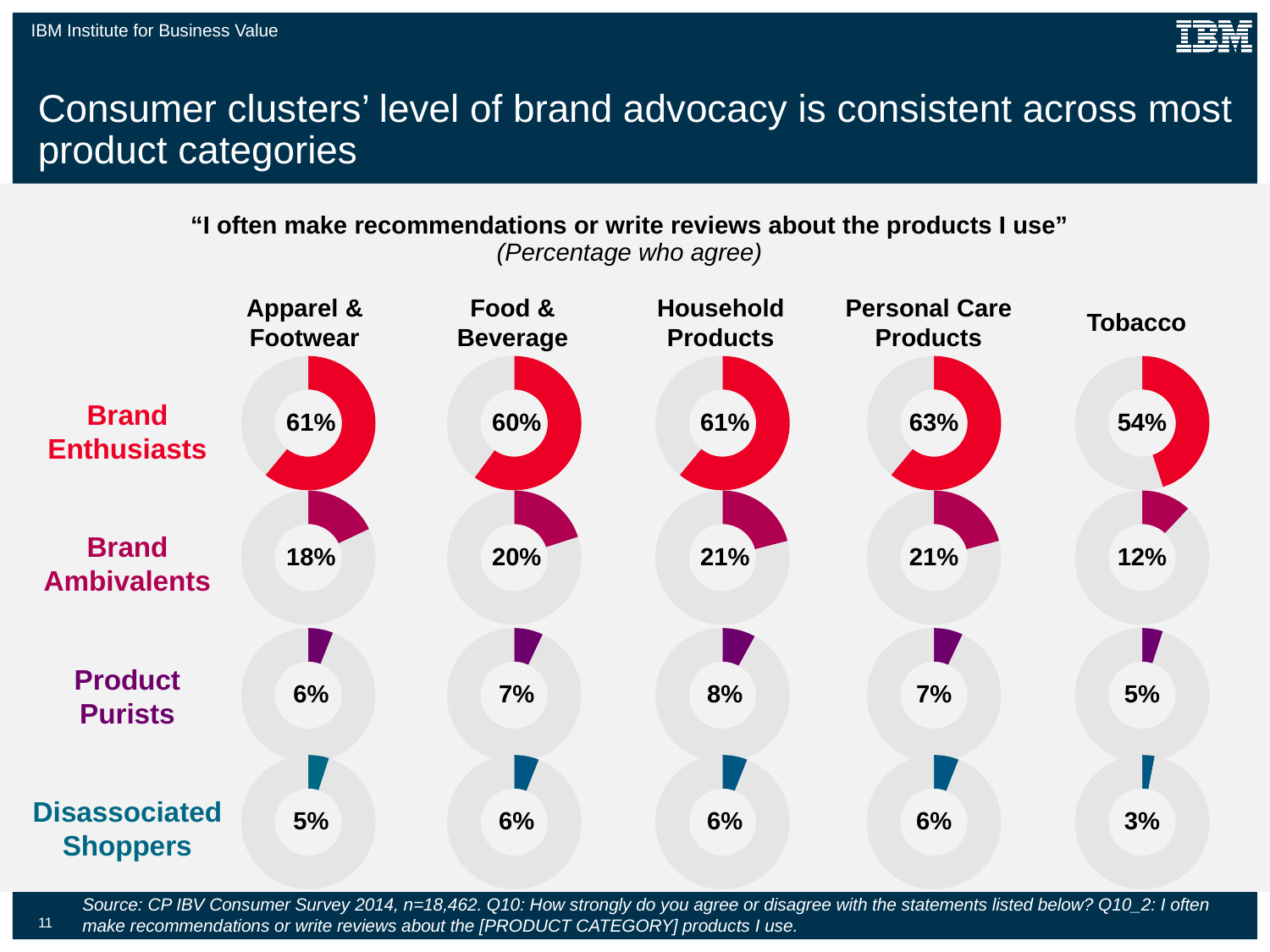
In the Disassociated Shoppers row, what percentage is shown for Apparel & Footwear? 5% In the Brand Ambivalents row, what percentage is shown for Tobacco? 12% In the Brand Ambivalents row, what is the difference between the Household Products value and the Apparel & Footwear value? 3% How many consumer clusters are shown as rows on the slide? 4 In the Brand Enthusiasts row, which product category has the highest percentage? Personal Care Products In the Brand Enthusiasts row, what percentage is shown for Personal Care Products? 63% In the Brand Enthusiasts row, what is the difference between the Personal Care Products value and the Tobacco value? 9% What kind of chart is used to display each percentage on the slide? Donut (pie) chart In the Product Purists row, what percentage is shown for Household Products? 8% How many product categories are shown across the top of the chart grid? 5 In the Product Purists row, which is larger: the value for Household Products or the value for Food & Beverage? Household Products In the Brand Ambivalents row, which product category has the lowest percentage? Tobacco